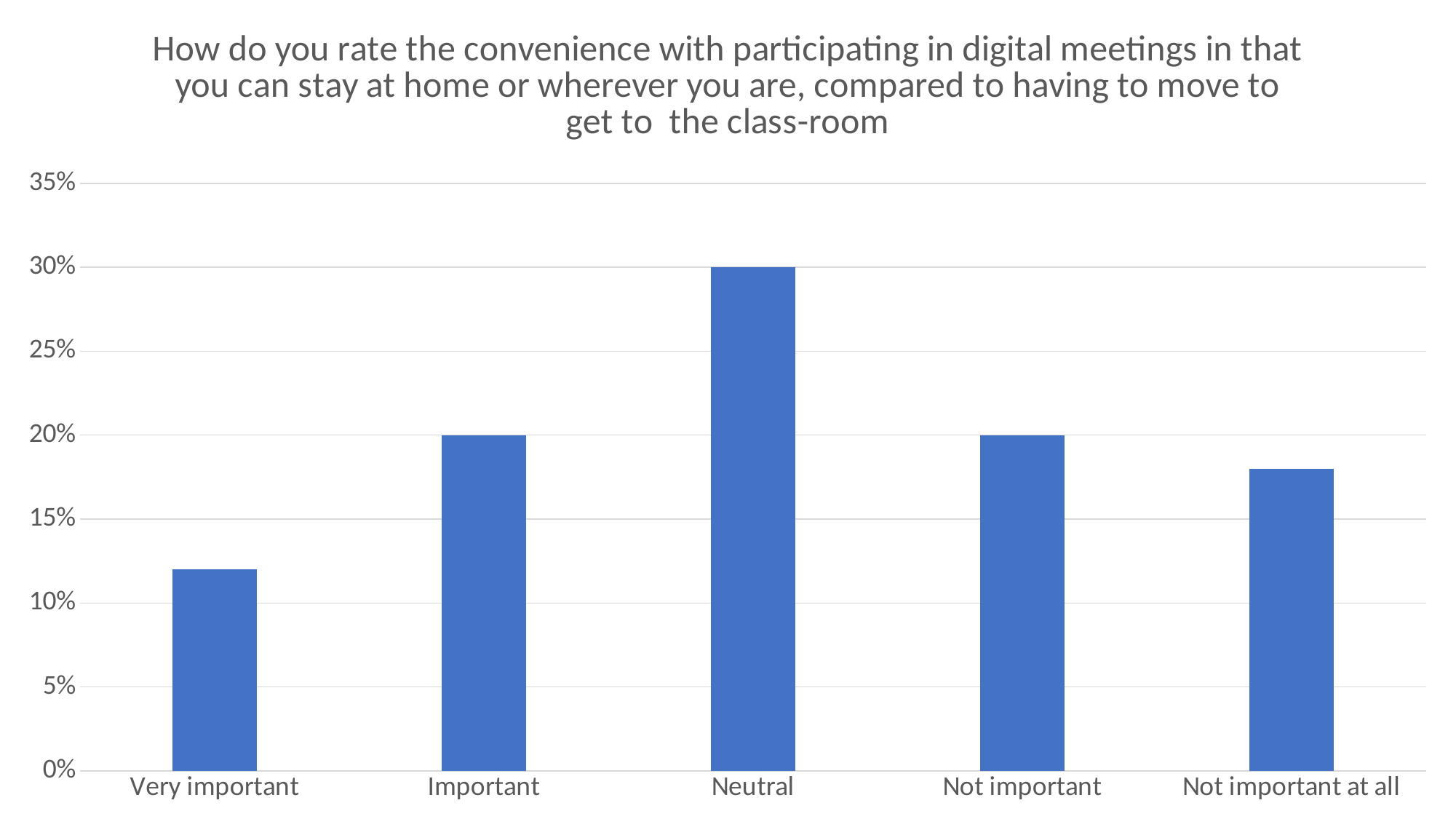
What is the difference between the values for Neutral and Important? 10% How many categories are shown on the x axis? 5 Which category has the highest value? Neutral What is the value for Important? 20% Is the value for Very important greater or less than 15%? less Which category has the lowest value? Very important Is the value for Not important at all greater or less than 20%? less What kind of chart is shown on the slide? Bar chart Which is larger, the value for Very important or the value for Not important at all? Not important at all What is the value for Neutral? 30% What is the value for Not important? 20% What colour are the bars in the chart? Blue